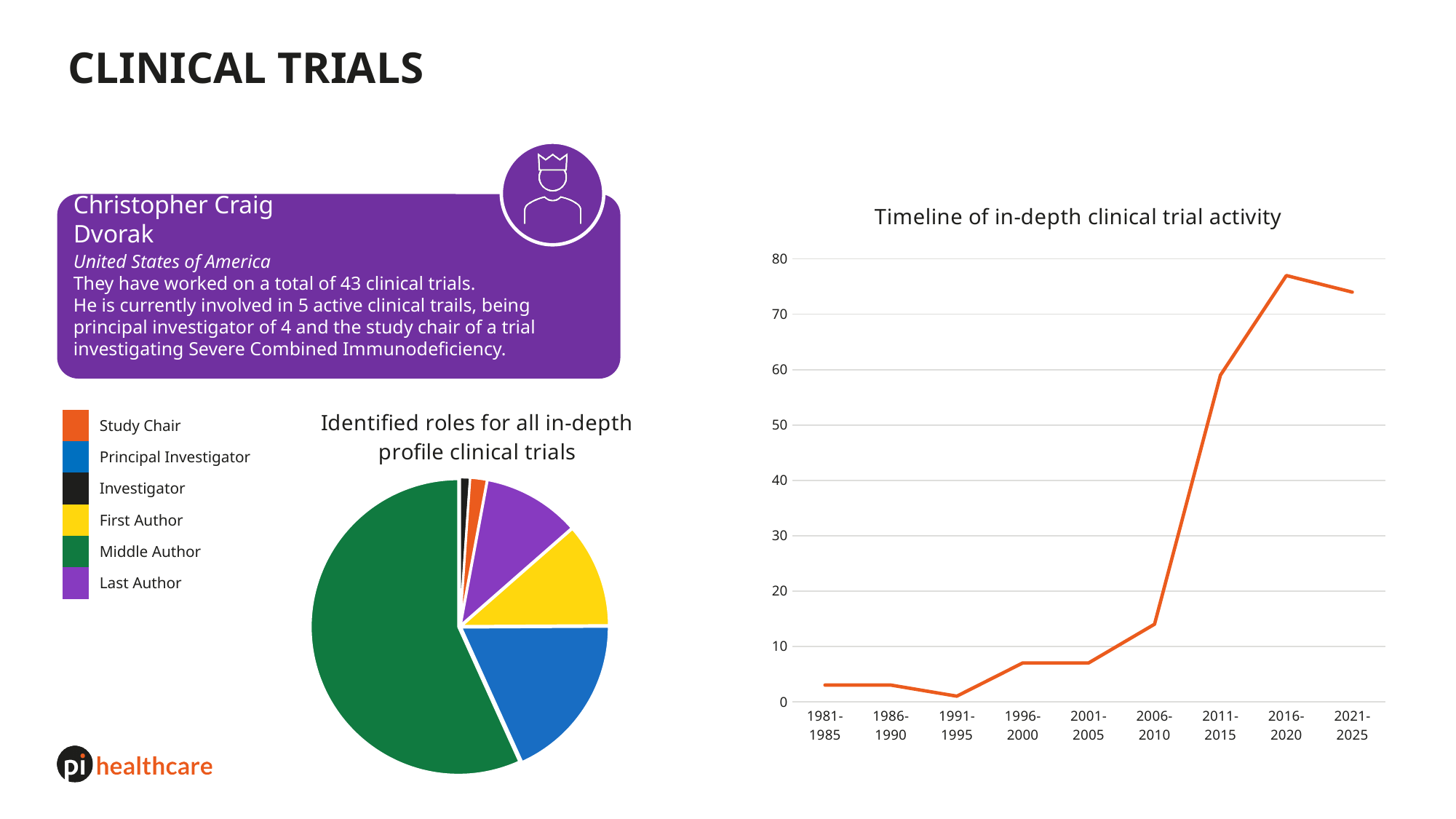
What kind of chart is the 'Identified roles for all in-depth profile clinical trials' chart? pie chart In the 'Timeline of in-depth clinical trial activity' chart, is the value for 1996-2000 greater or less than 10? less In the 'Timeline of in-depth clinical trial activity' chart, how many periods are plotted on the x axis? 9 What kind of chart is the 'Timeline of in-depth clinical trial activity' chart? line chart In the 'Timeline of in-depth clinical trial activity' chart, which period has the lowest value? 1991-1995 In the 'Timeline of in-depth clinical trial activity' chart, is the value for 2016-2020 greater or less than 70? greater In the 'Timeline of in-depth clinical trial activity' chart, which period has the highest value? 2016-2020 In the 'Identified roles for all in-depth profile clinical trials' pie chart, which role has the largest slice? Middle Author In the 'Timeline of in-depth clinical trial activity' chart, do the values generally rise or fall from 1981-1985 to 2016-2020? rise How many roles does the legend of the 'Identified roles for all in-depth profile clinical trials' pie chart list? 6 In the 'Timeline of in-depth clinical trial activity' chart, is the value for 2011-2015 greater or less than 50? greater In the 'Timeline of in-depth clinical trial activity' chart, which is larger, the value for 2006-2010 or the value for 2011-2015? 2011-2015